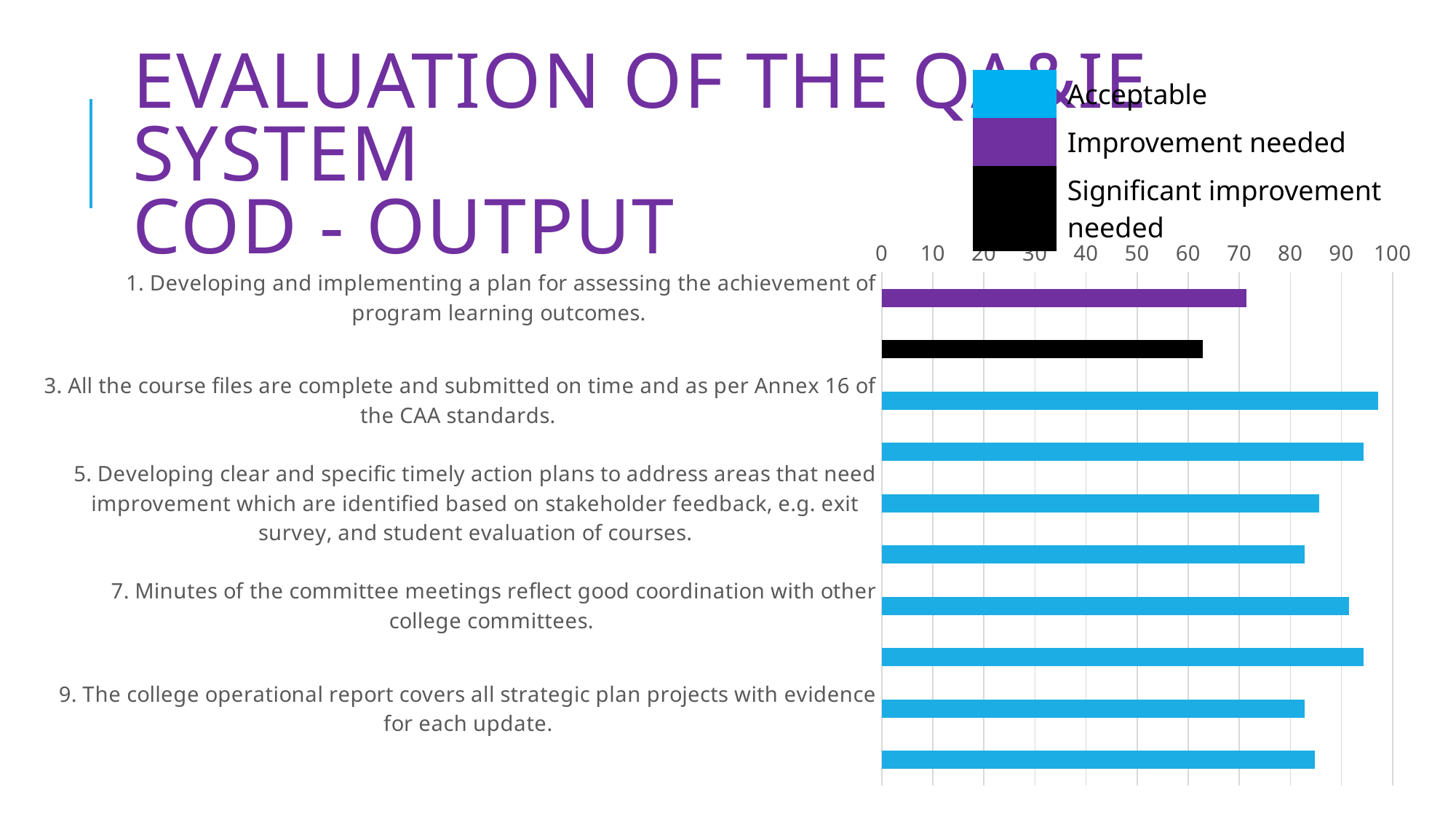
Which legend entry is shown in black? Significant improvement needed Is the value for item 7 (Minutes of the committee meetings reflect good coordination) greater or less than 80? greater Which has the larger value, item 1 or item 3? item 3 How many series does the legend list? 3 Which has the larger value, item 7 or item 9? item 7 Which legend entry is shown in purple? Improvement needed Is the value for item 5 (Developing clear and specific timely action plans) greater or less than 90? less How many bars are plotted in the chart? 10 Is the value for item 9 (The college operational report covers all strategic plan projects) greater or less than 90? less What kind of chart is shown on the slide? bar chart